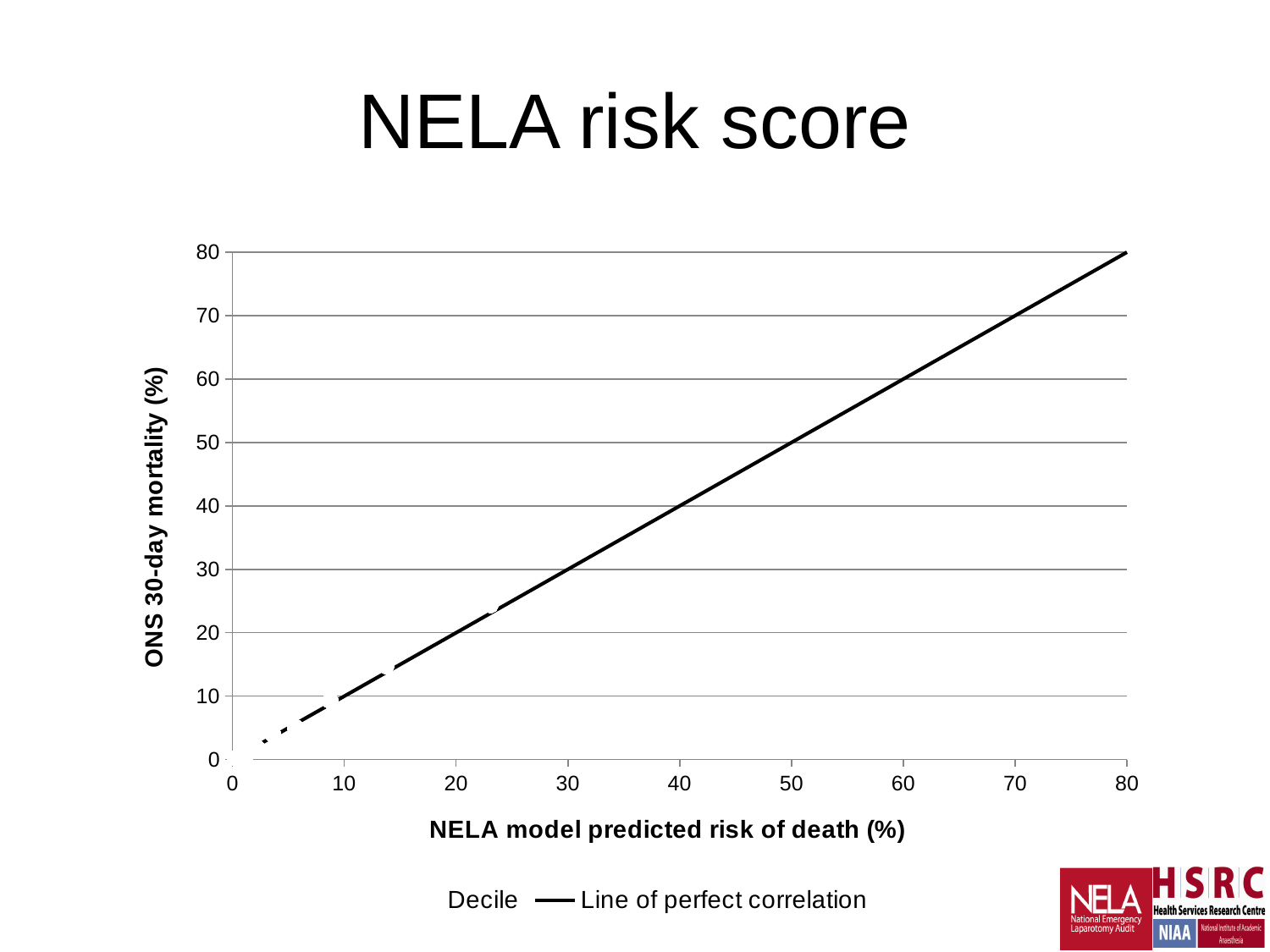
Is the ONS 30-day mortality value of the line of perfect correlation at a predicted risk of 20% greater or less than 30? less Is the ONS 30-day mortality value of the line of perfect correlation at a predicted risk of 60% greater or less than 50? greater What is the highest value shown on the y axis? 80 What are the two entries in the chart legend? Decile; Line of perfect correlation What is the ONS 30-day mortality (%) value of the line of perfect correlation when the NELA model predicted risk of death is 40%? 40 What is the ONS 30-day mortality (%) value of the line of perfect correlation at the right end of the x axis, where predicted risk is 80%? 80 What is the title of the slide's chart? NELA risk score What kind of chart is shown on the slide? line chart How many series does the legend list? 2 Does the line of perfect correlation rise or fall as the NELA model predicted risk of death increases? rise